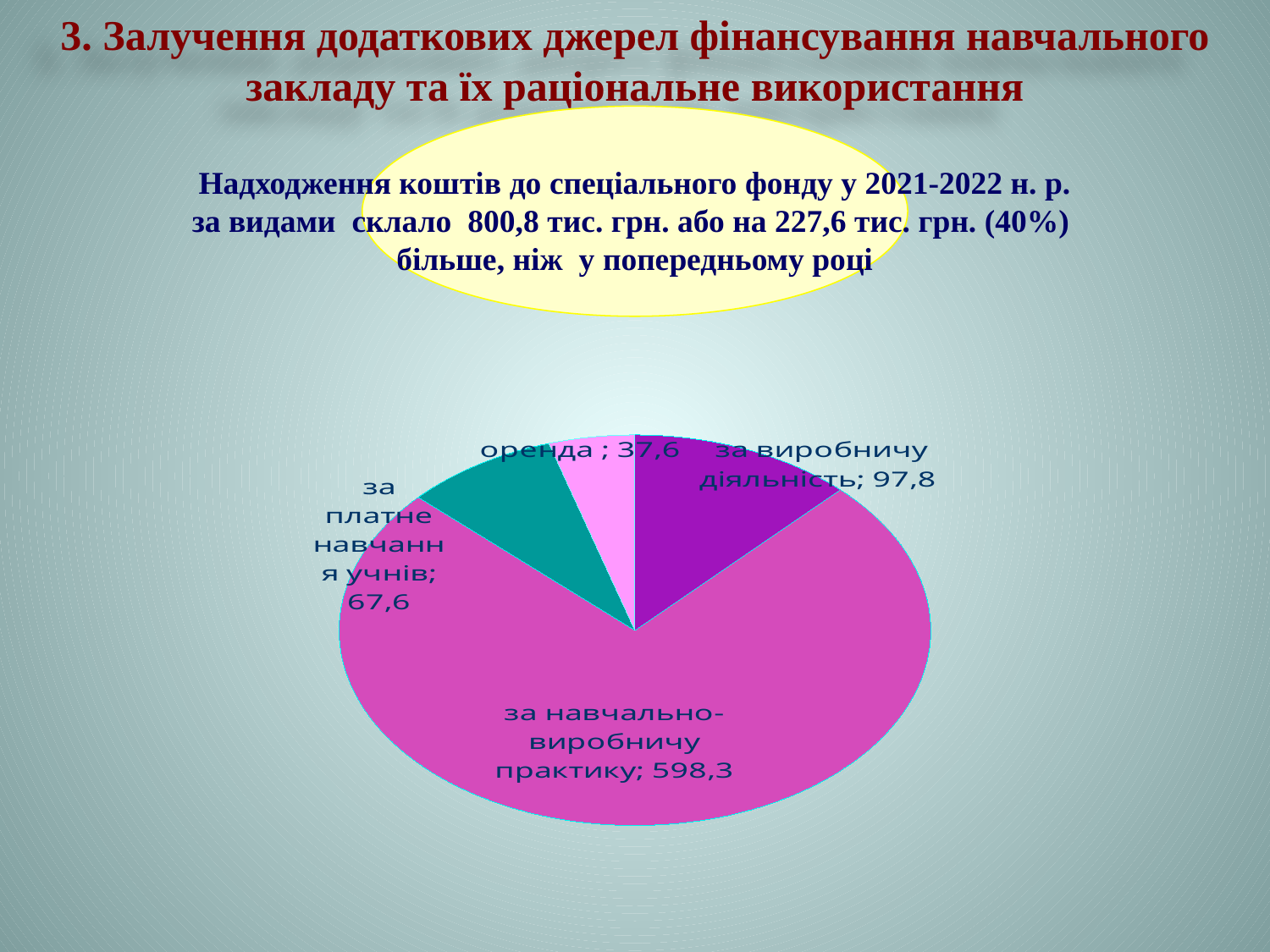
What is the value for "за виробничу діяльність" in the pie chart? 97,8 How many slices does the pie chart have? 4 What colour is the slice for "за навчально-виробничу практику"? magenta (pink) Which category has the largest slice in the pie chart? за навчально-виробничу практику What kind of chart is shown on the slide? pie chart Which category has the smallest slice in the pie chart? оренда What is the value for "за платне навчання учнів" in the pie chart? 67,6 What is the difference between the values for "за виробничу діяльність" and "за платне навчання учнів"? 30,2 What is the value for "за навчально-виробничу практику" in the pie chart? 598,3 What is the difference between the values for "за навчально-виробничу практику" and "за виробничу діяльність"? 500,5 Which is larger: the value for "за платне навчання учнів" or the value for "оренда"? за платне навчання учнів What is the value for "оренда" in the pie chart? 37,6